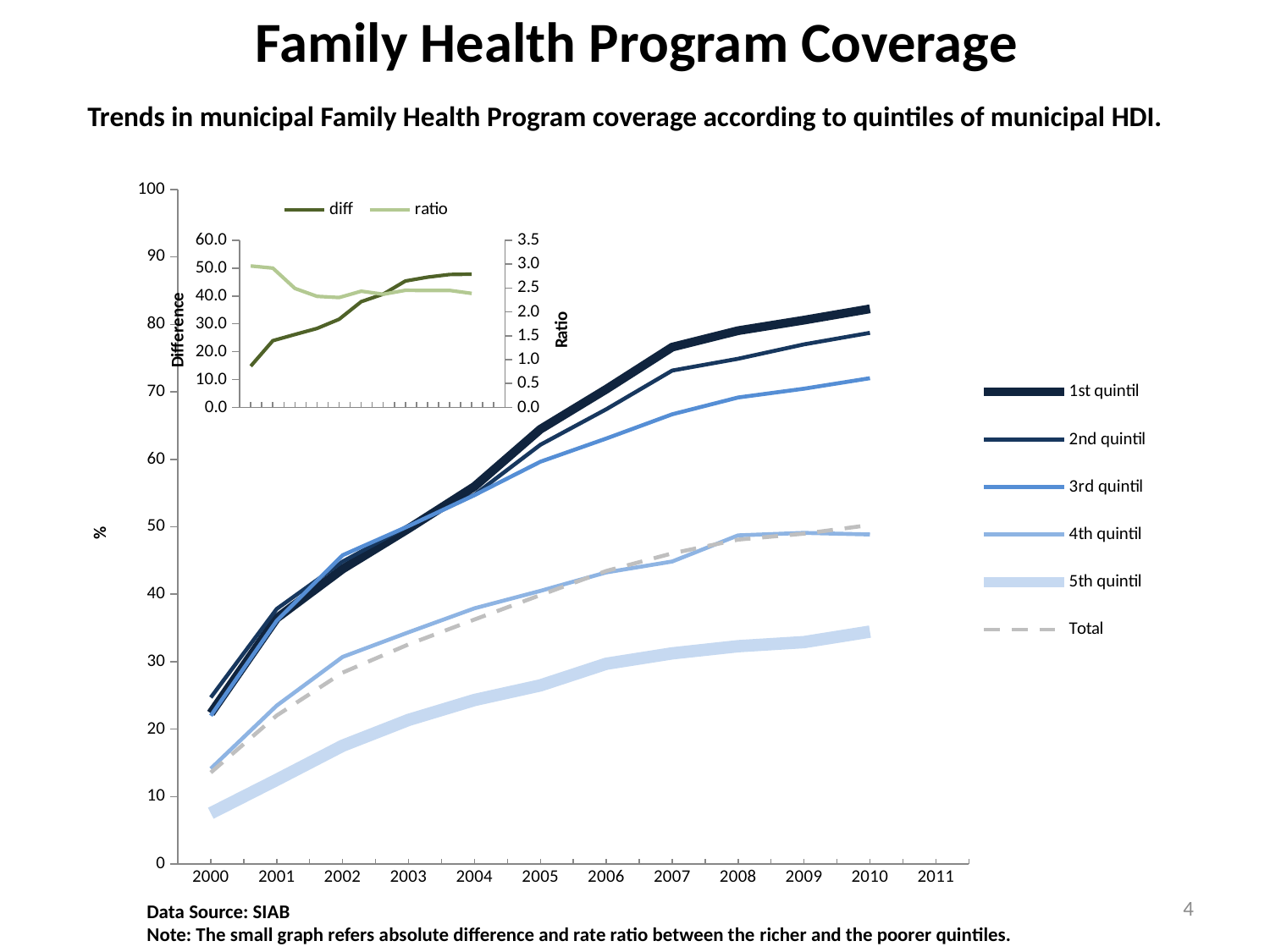
In the main chart, is the value for 1st quintil in 2010 greater or less than 80? greater How many series does the legend of the small inset chart list? 2 In the main chart, is the value for 5th quintil in 2010 greater or less than 30? greater In the main chart, which is larger in 2005: the value for 2nd quintil or the value for 4th quintil? 2nd quintil In the small inset chart, does the ratio series rise or fall from 2000 to 2010? fall In the main chart, which series has the lowest value in 2010? 5th quintil How many series does the legend of the main chart list? 6 What is the label of the y axis of the main chart? % In the main chart, is the value for 5th quintil in 2000 greater or less than 10? less What kind of chart is the main chart on the slide? line chart In the main chart, which series has the highest value in 2010? 1st quintil In the main chart, does the 1st quintil series rise or fall from 2000 to 2010? rise